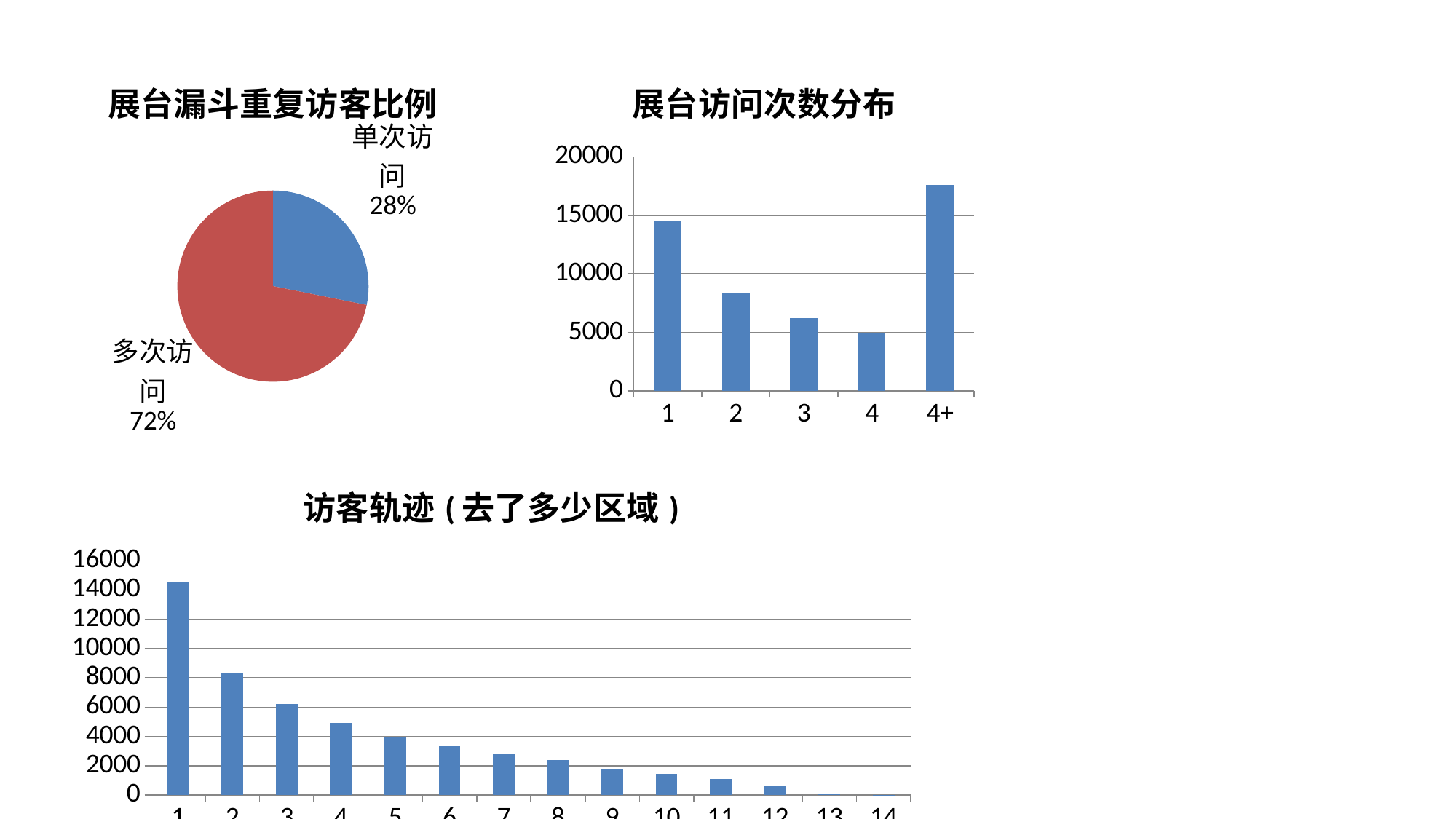
In the chart titled 展台漏斗重复访客比例, which slice is larger, 单次访问 or 多次访问? 多次访问 In the chart titled 访客轨迹（去了多少区域）, is the value for category 2 greater or less than 6000? greater In the chart titled 访客轨迹（去了多少区域）, do the values rise or fall from category 1 to category 14? fall In the chart titled 展台访问次数分布, is the value for category 1 greater or less than 10000? greater In the chart titled 展台漏斗重复访客比例, what share of the pie is 多次访问? 72% In the chart titled 展台漏斗重复访客比例, what share of the pie is 单次访问? 28% In the chart titled 展台访问次数分布, which category has the highest value? 4+ What kind of chart is the one titled 展台漏斗重复访客比例? pie chart How many categories are shown on the x axis of the chart titled 展台访问次数分布? 5 How many categories are shown on the x axis of the chart titled 访客轨迹（去了多少区域）? 14 In the chart titled 展台访问次数分布, is the value for category 3 greater or less than 10000? less In the chart titled 展台访问次数分布, which category has the lowest value? 4